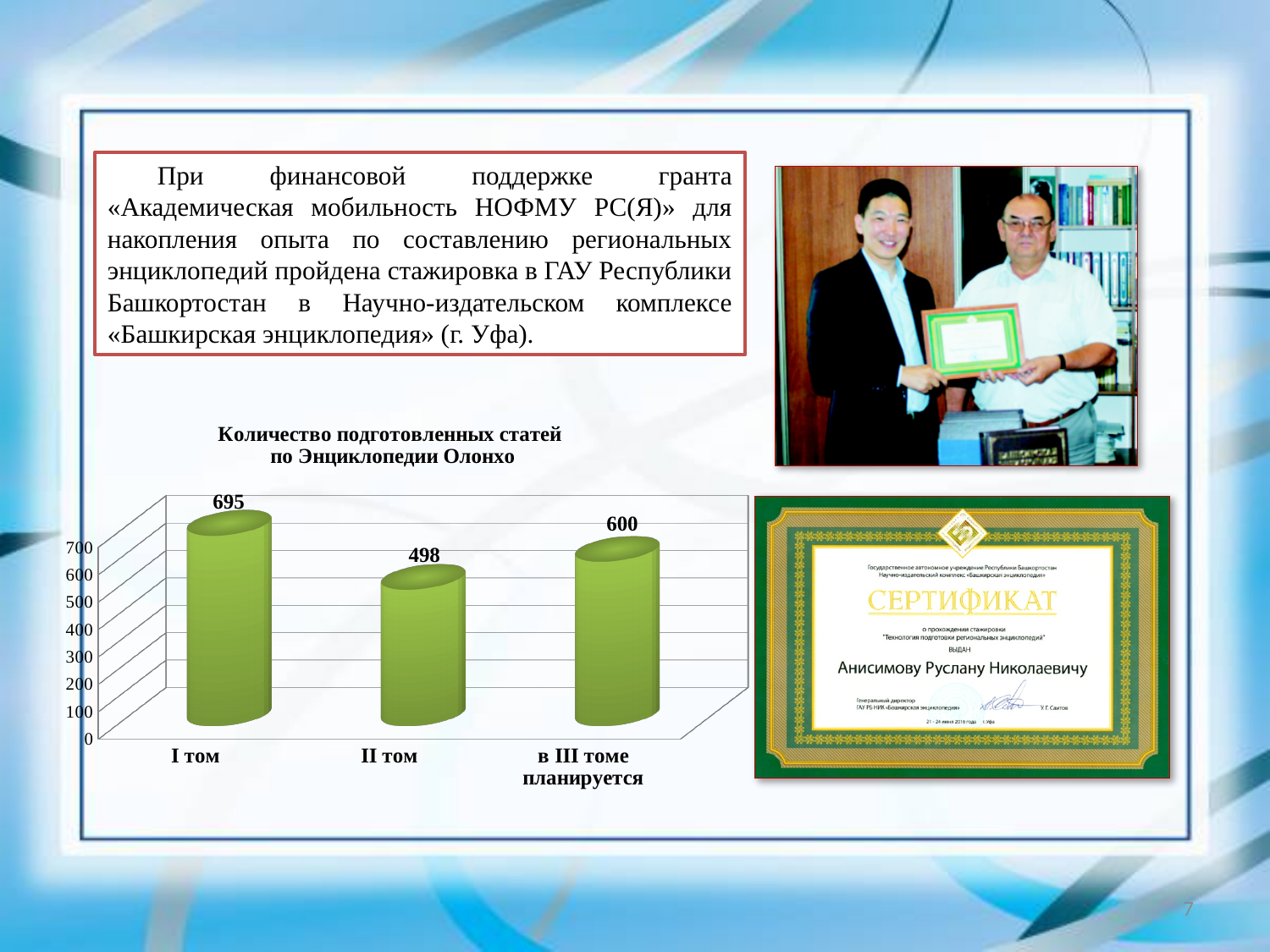
What is the value for в III томе планируется? 600 How many categories are shown in the chart? 3 Which category has the highest value? I том What is the difference between the values for в III томе планируется and II том? 102 Which is larger, the value for I том or the value for в III томе планируется? I том What kind of chart is shown on the slide? bar chart What is the value for I том? 695 What is the title of the chart? Количество подготовленных статей по Энциклопедии Олонхо Is the value for II том greater or less than 500? less What is the value for II том? 498 Which category has the lowest value? II том What is the difference between the values for I том and II том? 197